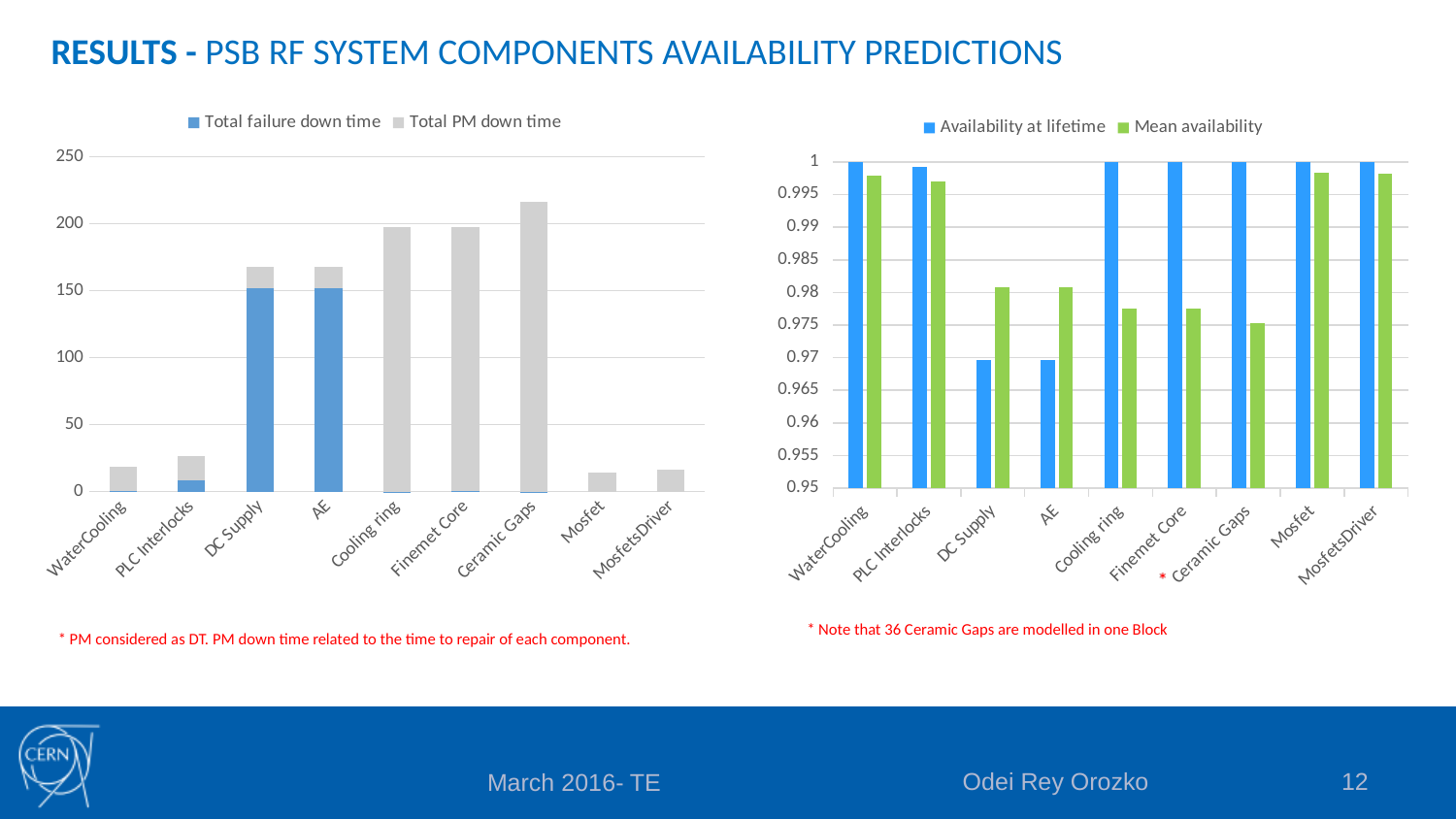
In the right chart, is the Availability at lifetime for DC Supply greater or less than 0.975? less How many series does the legend of the right chart list? 2 What kind of chart is the right chart (Availability at lifetime / Mean availability)? Bar chart What kind of chart is the left chart (Total failure down time / Total PM down time)? Stacked bar chart In the right chart, which is larger: the Availability at lifetime for WaterCooling or for AE? WaterCooling In the right chart, is the Mean availability for Mosfet greater or less than 0.995? greater How many components are shown on the x axis of the left chart? 9 In the left chart, is the total down time for PLC Interlocks greater or less than 50? less In the left chart, which component has the highest total down time? Ceramic Gaps In the left chart, which colour represents Total PM down time? Grey